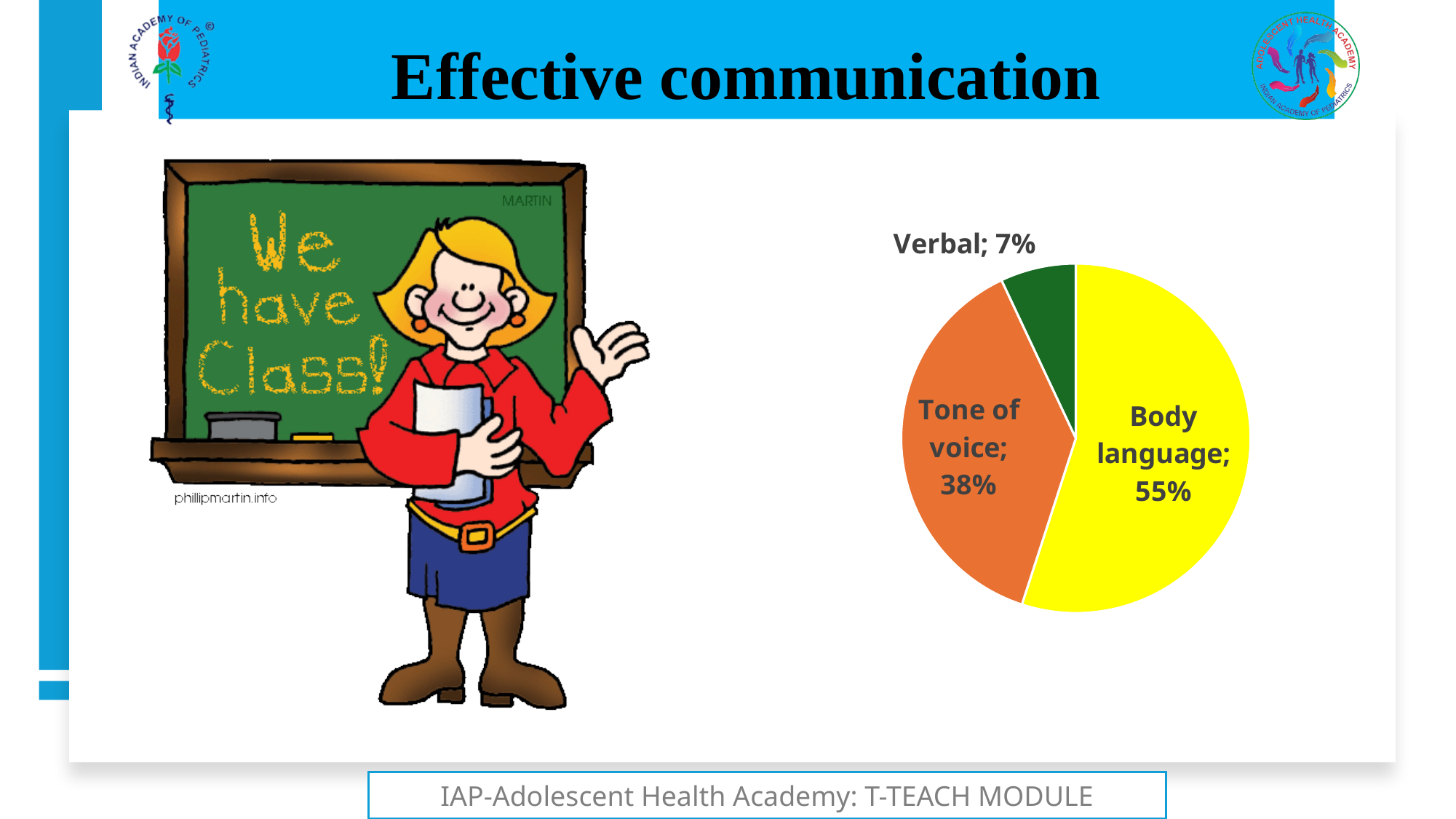
What is the difference between the Tone of voice and Verbal percentages? 31% What percentage does the pie chart show for Verbal? 7% What colour is the Verbal slice in the pie chart? green What percentage does the pie chart show for Body language? 55% Which is larger, Tone of voice or Verbal? Tone of voice Which slice of the pie chart is the smallest? Verbal Which slice of the pie chart is the largest? Body language What is the difference between the Body language and Tone of voice percentages? 17% What colour is the Body language slice in the pie chart? yellow What kind of chart is shown on the slide? pie chart How many slices does the pie chart have? 3 What percentage does the pie chart show for Tone of voice? 38%